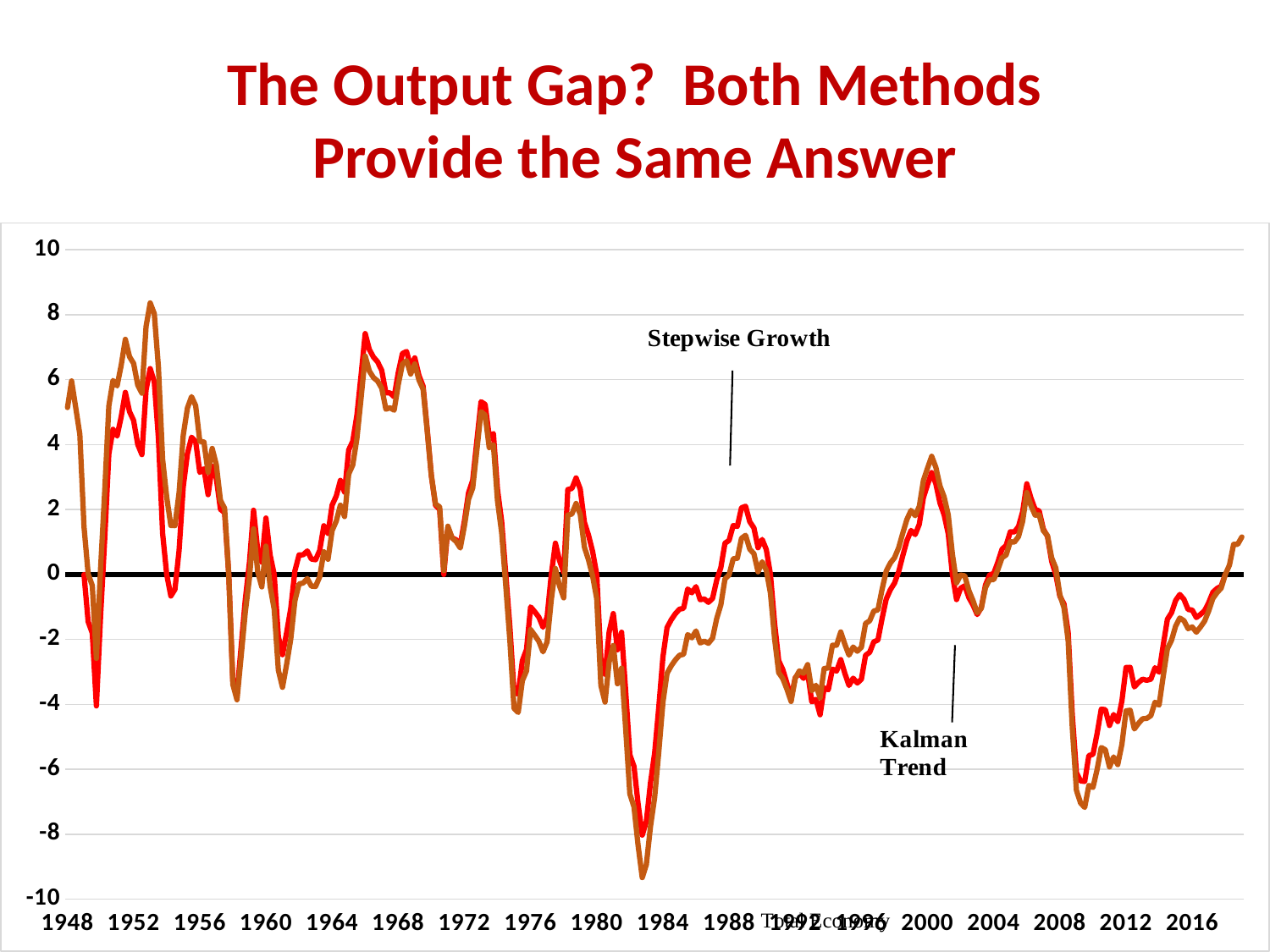
Is the value of the lines around 1983 greater or less than -6? less Is the peak value of the brown line around 1953 greater or less than 8? greater What are the names of the two series labelled on the chart? Stepwise Growth and Kalman Trend What kind of chart is shown on the slide? line chart What is the title of the slide? The Output Gap? Both Methods Provide the Same Answer Is the value of the lines around 2009 greater or less than -4? less How many series (lines) are plotted on the chart? 2 How many year labels are shown on the x axis? 18 Do the lines rise or fall between 2009 and 2016? rise